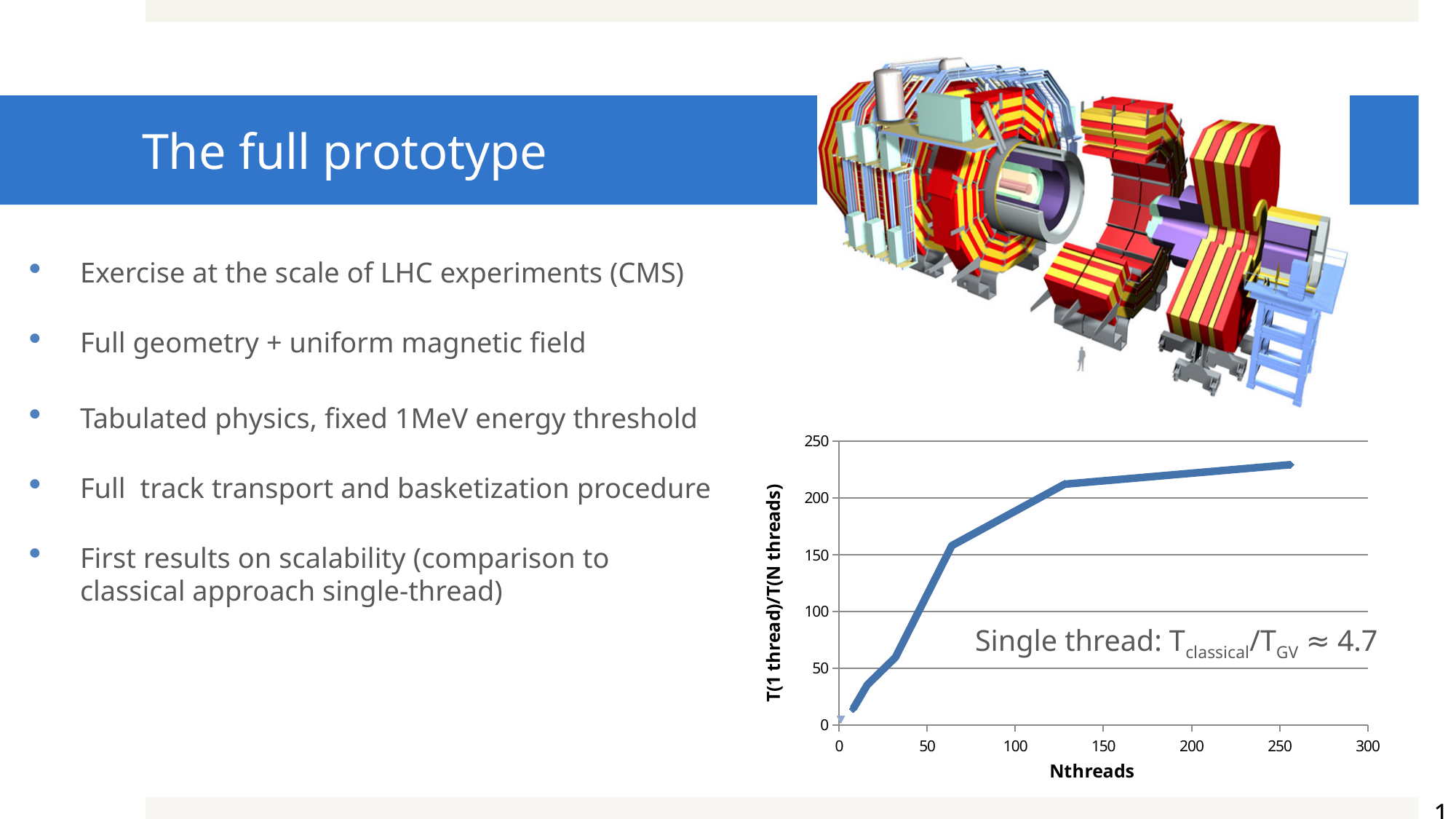
Is the value at about 16 threads greater or less than 50? less Which has the larger value, the point at about 64 threads or the point at about 256 threads? 256 threads What is the label of the x axis of the chart? Nthreads Is the value at about 32 threads greater or less than 100? less Is the value at about 256 threads greater or less than 200? greater What is the maximum value shown on the y axis of the chart? 250 Does the plotted value rise or fall as Nthreads increases? rise What kind of chart is shown at the bottom right of the slide? line chart What is the label of the y axis of the chart? T(1 thread)/T(N threads)